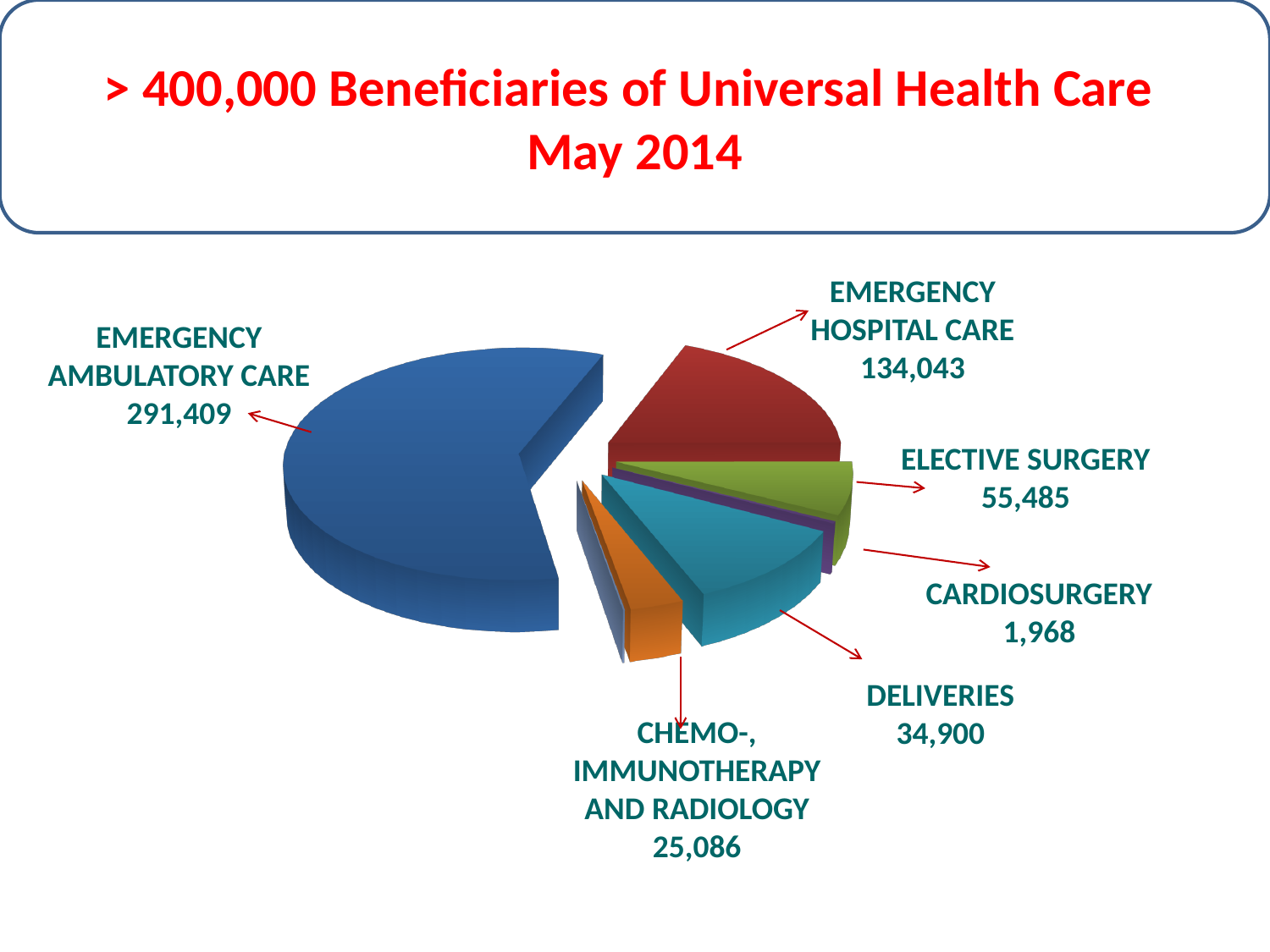
Which is larger, Deliveries or Elective Surgery? Elective Surgery What is the value for Elective Surgery? 55,485 What is the value for Cardiosurgery? 1,968 What is the value for Chemo-, Immunotherapy and Radiology? 25,086 What is the value for Emergency Ambulatory Care? 291,409 What kind of chart is shown on the slide? Pie chart What is the difference between Emergency Ambulatory Care and Emergency Hospital Care? 157,366 What is the value for Emergency Hospital Care? 134,043 Which category has the lowest value? Cardiosurgery Which category has the highest value? Emergency Ambulatory Care What is the title of the slide? > 400,000 Beneficiaries of Universal Health Care May 2014